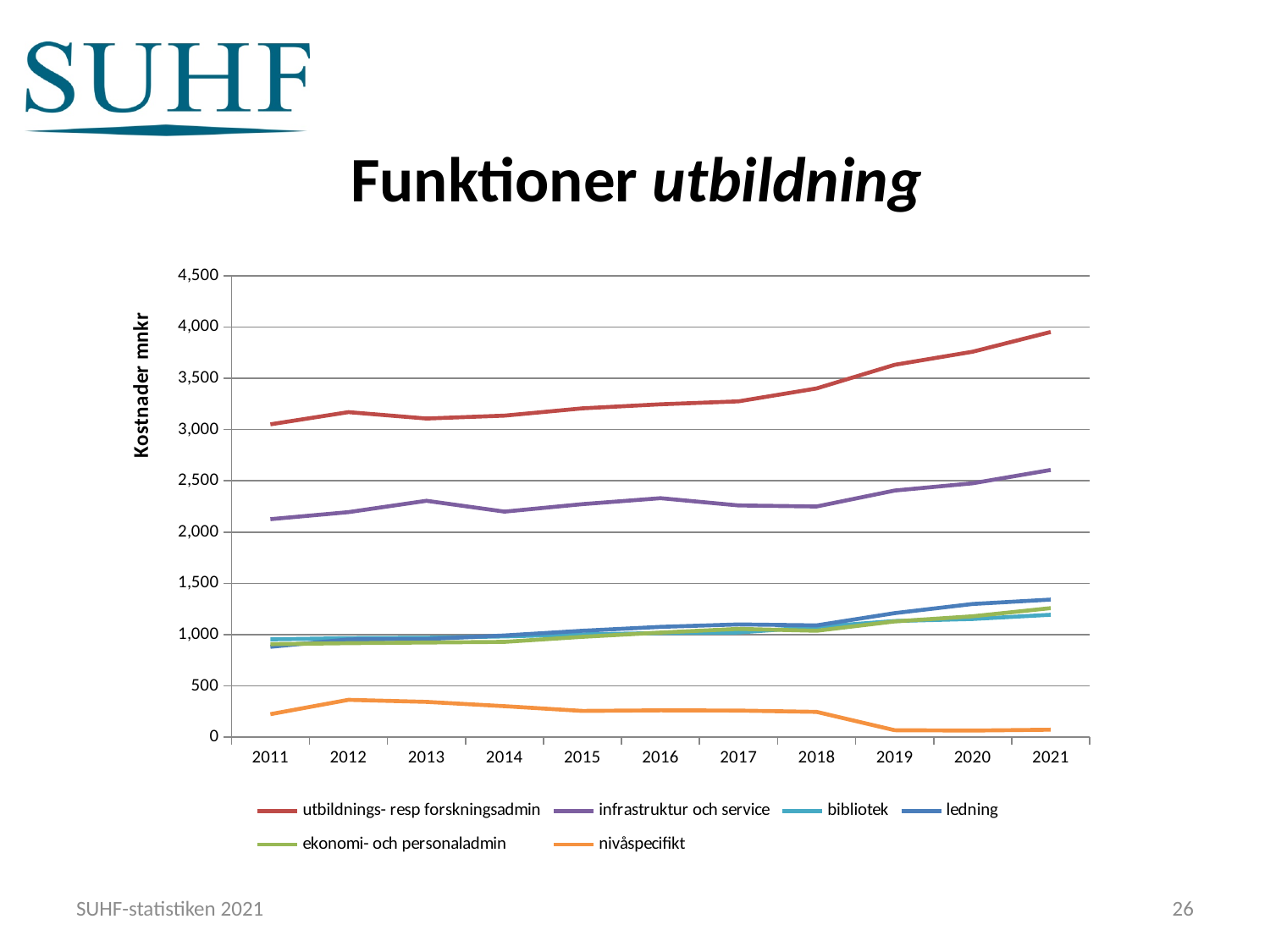
Is the value for infrastruktur och service in 2011 greater or less than 2,500? less How many series does the legend list? 6 What kind of chart is shown on the slide? line chart Which series has the lowest value in 2021? nivåspecifikt Which series has the highest value in 2021? utbildnings- resp forskningsadmin What is the title of the y axis? Kostnader mnkr Is the value for utbildnings- resp forskningsadmin in 2021 greater or less than 3,500? greater Which is larger in 2021, infrastruktur och service or ledning? infrastruktur och service How many years are shown on the x axis? 11 Is the value for nivåspecifikt in 2019 greater or less than 500? less Does the utbildnings- resp forskningsadmin series rise or fall from 2011 to 2021? rises